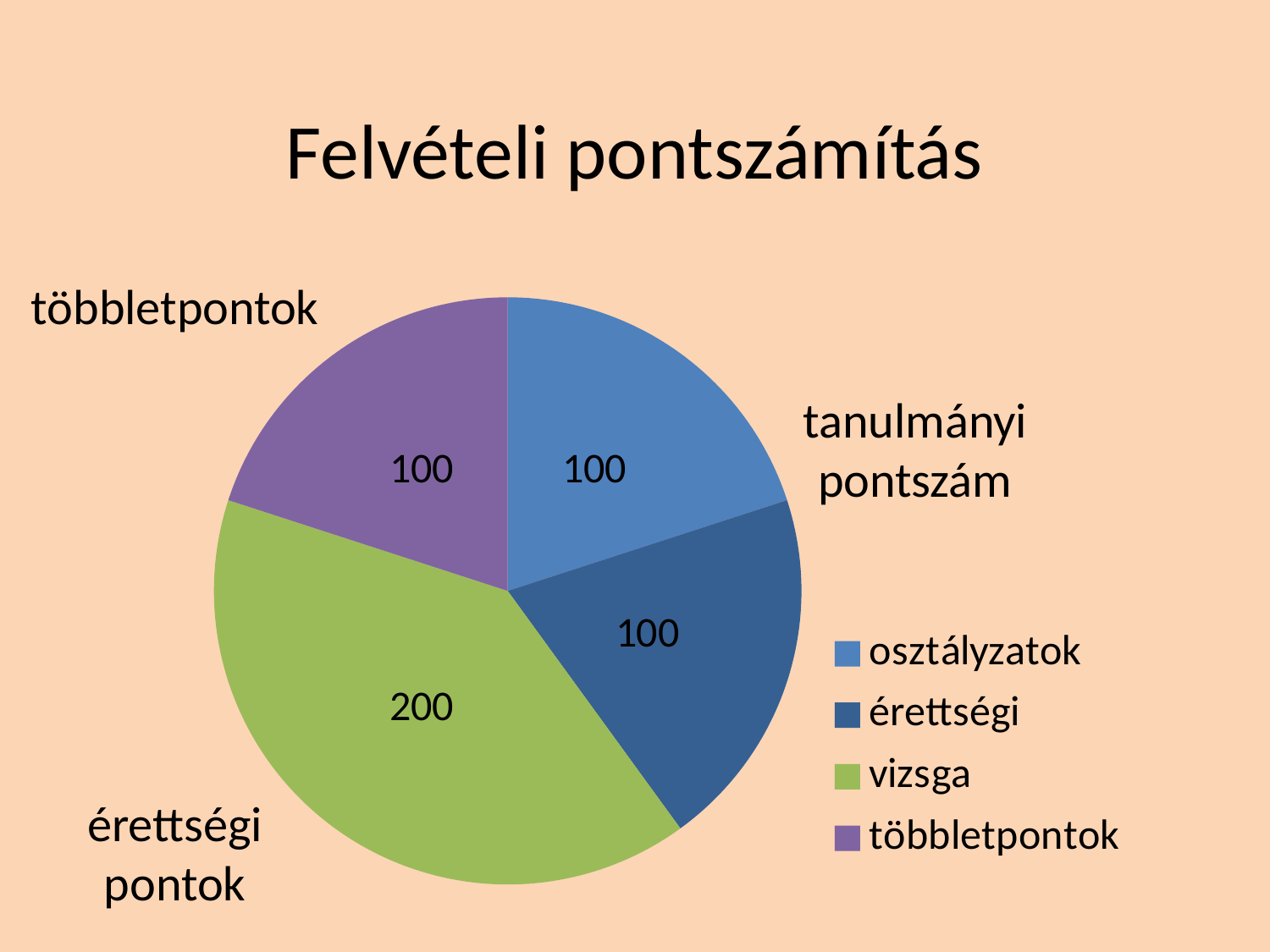
What share of the pie does the vizsga slice represent? 40% Which category has the largest slice? vizsga What is the total of all slices in the pie chart? 500 What is the title of the slide? Felvételi pontszámítás How many slices does the pie chart have? 4 What is the value of the vizsga slice? 200 What is the value of the többletpontok slice? 100 What is the value of the osztályzatok slice? 100 What kind of chart is shown on the slide? pie chart What is the difference between the vizsga value and the érettségi value? 100 Which is larger, the vizsga slice or the többletpontok slice? vizsga How many entries does the legend list? 4